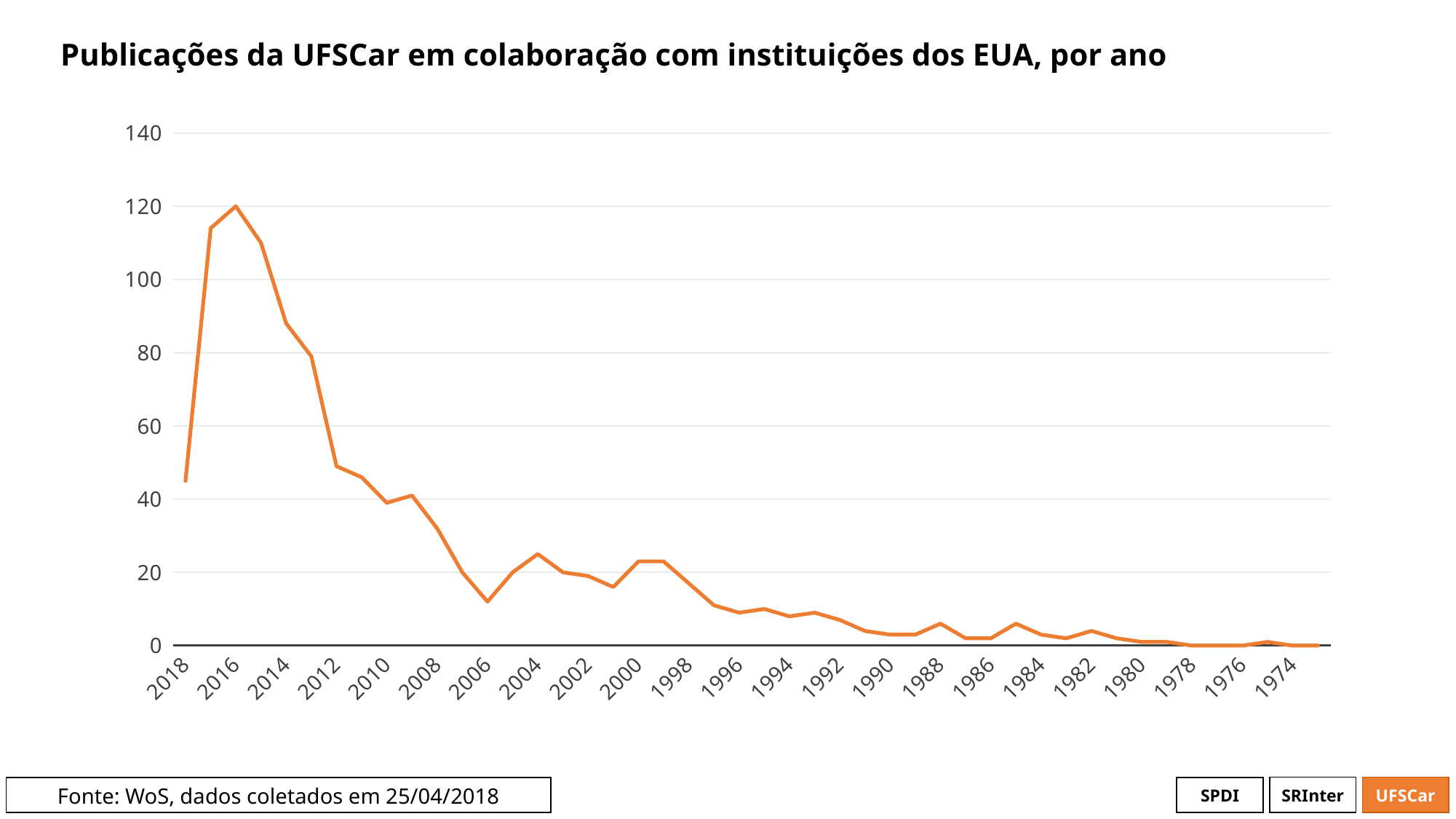
Is the value for 2004 greater or less than 20? greater Is the value for 2014 greater or less than 80? greater In which year does the line reach its highest value? 2016 Which year has the larger value, 2016 or 2018? 2016 What is the title of the chart? Publicações da UFSCar em colaboração com instituições dos EUA, por ano Moving from left (2018) to right (1974) along the x axis, do the values generally rise or fall? fall What kind of chart is shown on the slide? line chart How many year labels are shown on the x axis? 23 Is the value for 2006 greater or less than 20? less Which year has the larger value, 2004 or 2006? 2004